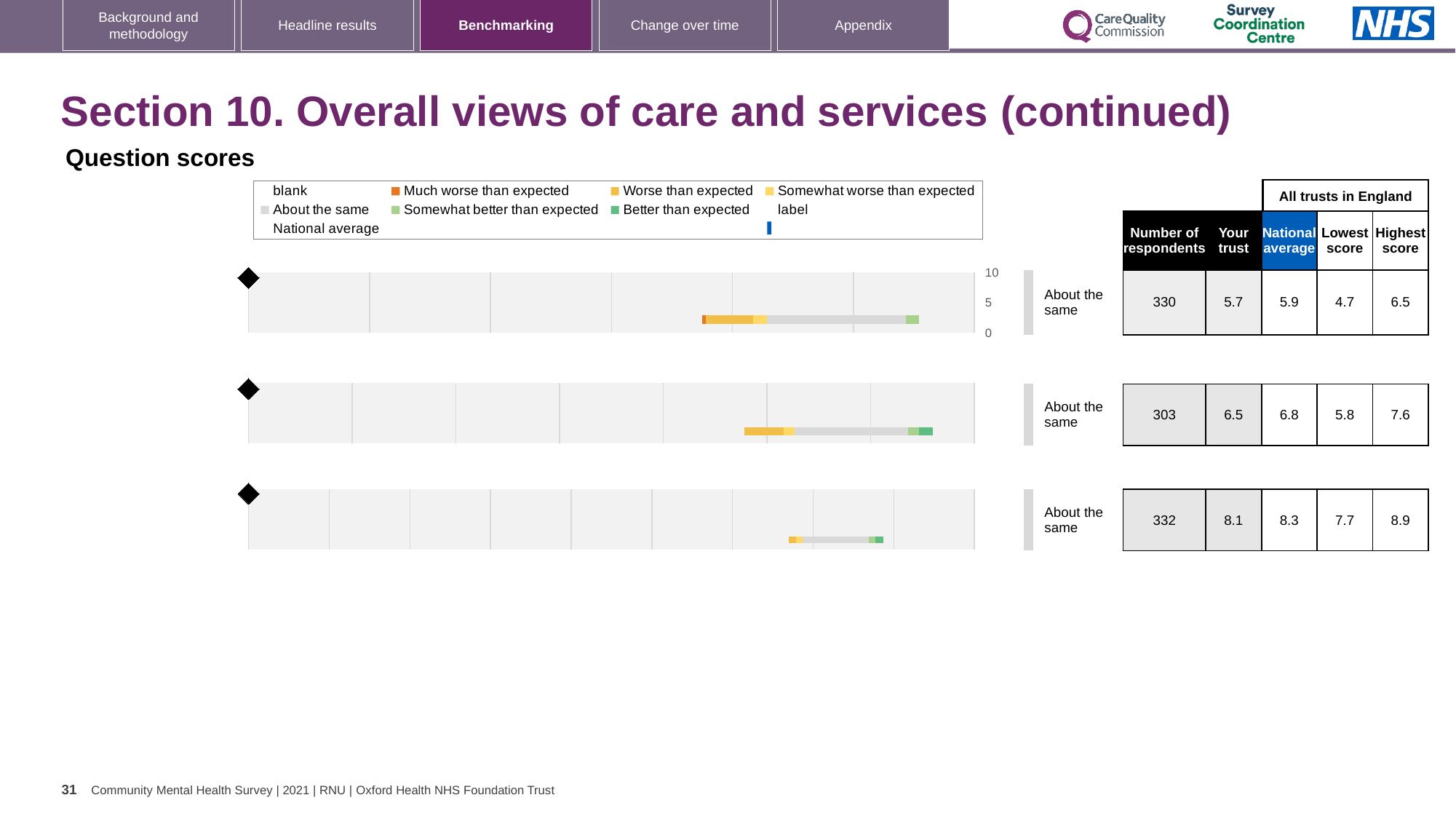
In the chart legend, which colour represents 'About the same'? grey For the top chart, which is larger: the 'Your trust' score or the national average? National average For the bottom chart, how many respondents are shown in the table beside it? 332 How many benchmarking charts are shown on the slide? 3 What benchmark category is given for the middle chart? About the same For the top chart, what is the 'Your trust' score shown in the table beside it? 5.7 In the chart legend, which category is shown in orange? Much worse than expected For the middle chart, what is the lowest score among all trusts in England shown in the table? 5.8 For the bottom chart, what is the difference between the highest score and the lowest score shown in the table? 1.2 Which of the three charts has the highest 'Your trust' score? the bottom chart For the middle chart, what is the national average shown in the table beside it? 6.8 What kind of chart is used to show the benchmarking results on this slide? bar chart